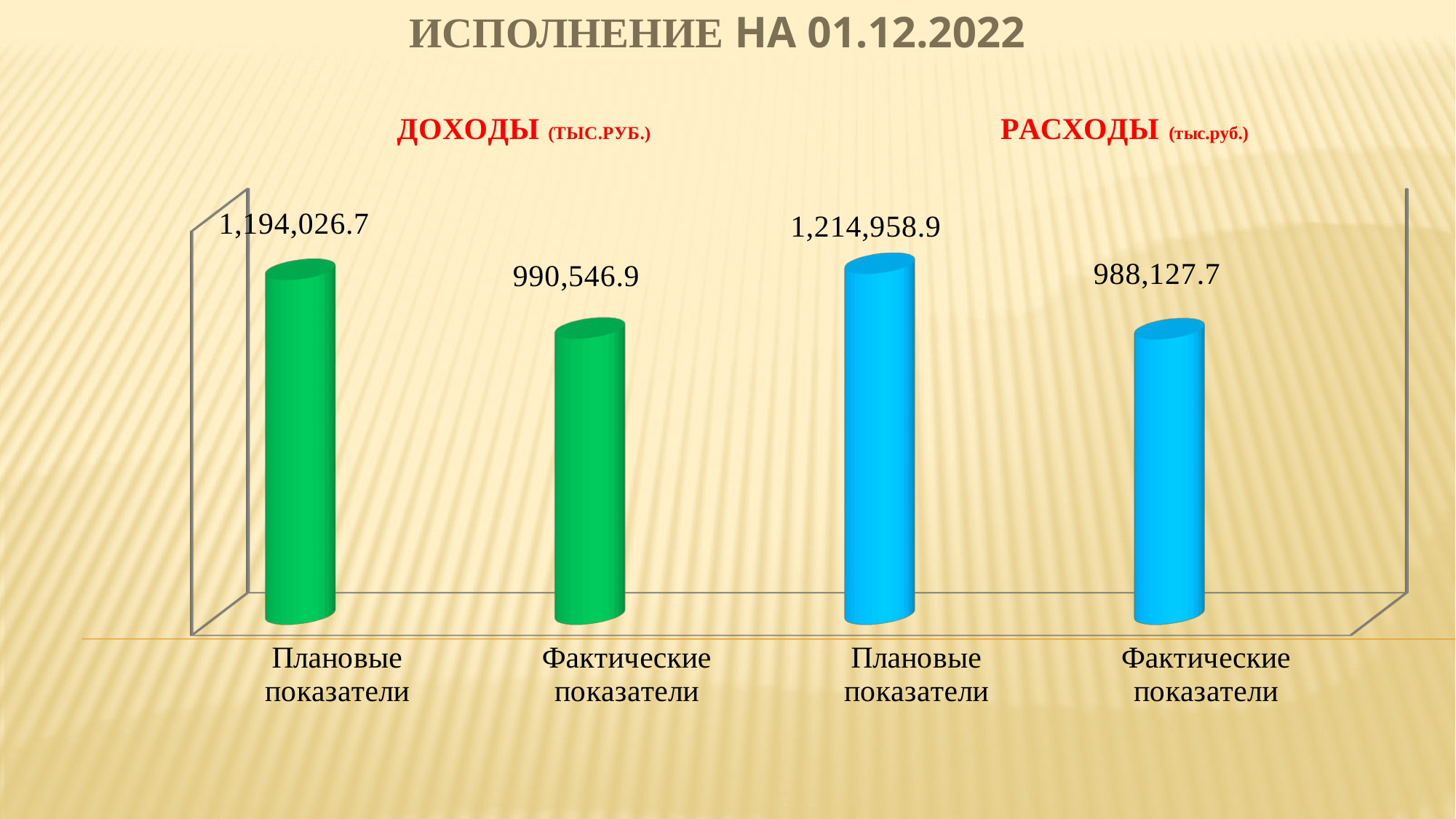
Which bar has the lowest value on the chart? Фактические показатели (РАСХОДЫ), 988,127.7 What is the value of the actual indicators (Фактические показатели) bar under ДОХОДЫ? 990,546.9 What kind of chart is shown on the slide? Bar chart What is the difference between the planned and actual indicators under РАСХОДЫ? 226,831.2 What colour are the bars for РАСХОДЫ? Blue What is the value of the planned indicators (Плановые показатели) bar under ДОХОДЫ? 1,194,026.7 Which bar has the highest value on the chart? Плановые показатели (РАСХОДЫ), 1,214,958.9 How many bars are plotted on the chart? 4 What is the value of the planned indicators (Плановые показатели) bar under РАСХОДЫ? 1,214,958.9 What is the difference between the planned and actual indicators under ДОХОДЫ? 203,479.8 What is the value of the actual indicators (Фактические показатели) bar under РАСХОДЫ? 988,127.7 Which is larger: the planned indicators for ДОХОДЫ or the planned indicators for РАСХОДЫ? Плановые показатели for РАСХОДЫ (1,214,958.9)